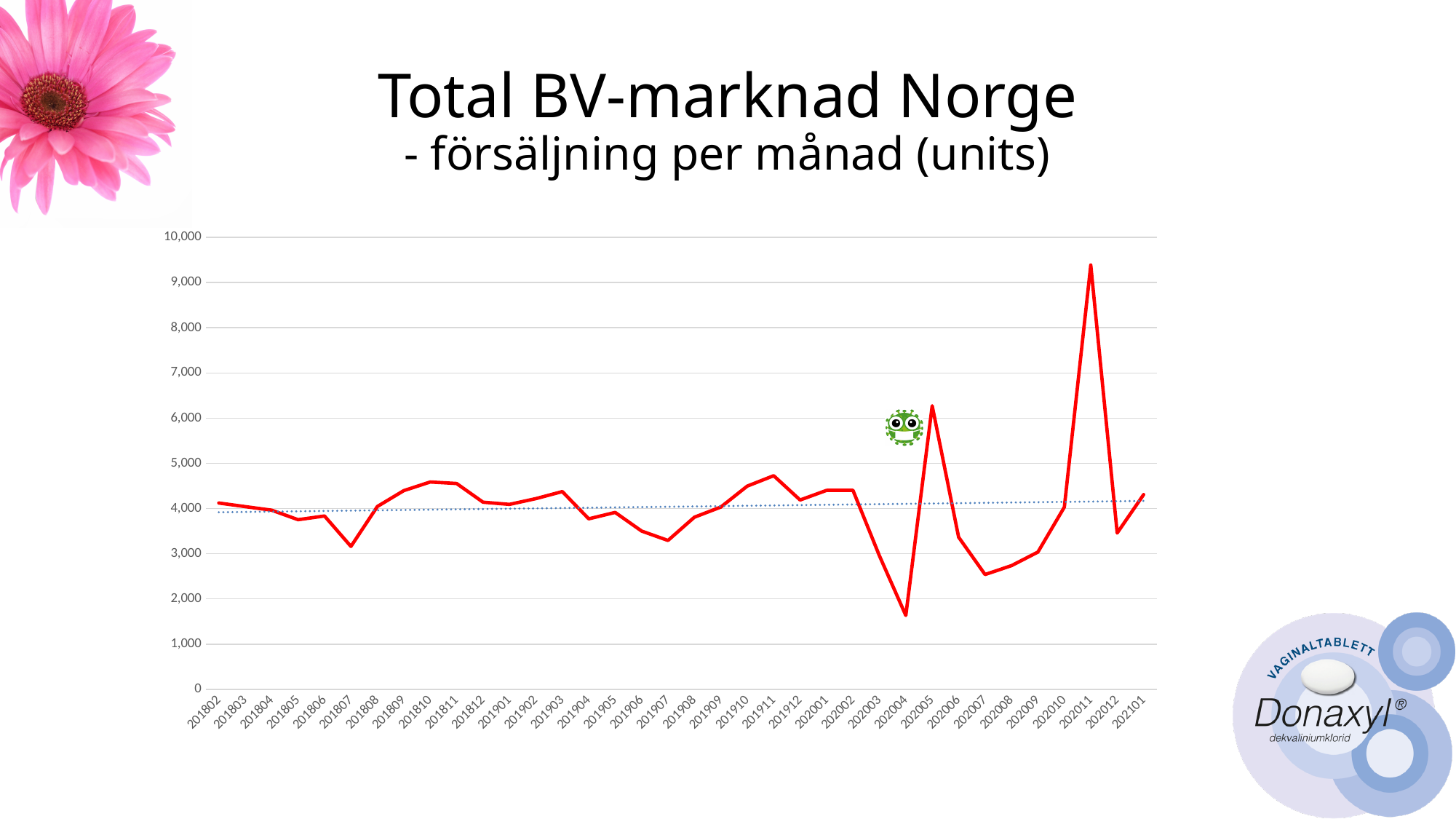
Is the value for 202011 greater or less than 9,000? greater Is the value for 201907 greater or less than 4,000? less Is the value for 202007 greater or less than 3,000? less How many monthly data points are plotted along the x axis? 36 Which month has the lowest value on the chart? 202004 What is the main title of the chart on the slide? Total BV-marknad Norge Do the values rise or fall from 202011 to 202012? fall What kind of chart is shown on the slide? line chart Which month has the highest value on the chart? 202011 Which is larger, the value for 202011 or the value for 202005? 202011